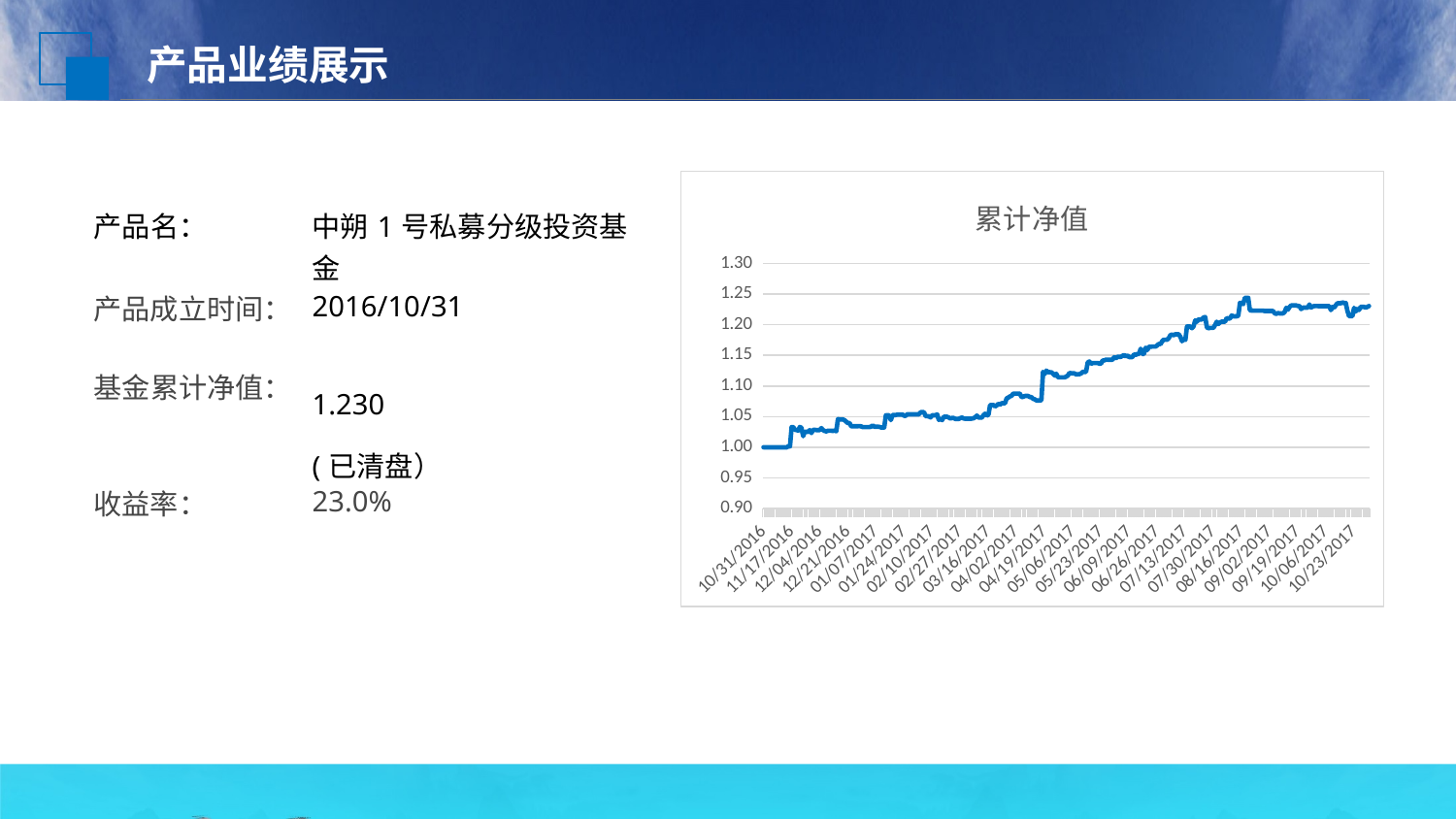
What is the highest value shown on the y axis of the 累计净值 chart? 1.30 How many lines are plotted in the 累计净值 chart? 1 Do the values in the 累计净值 chart generally rise or fall from left to right along the x axis? rise Is the lowest point of the line in the 累计净值 chart greater or less than 0.95? greater Is the value at 08/16/2017 in the 累计净值 chart greater or less than 1.20? greater What is the first date label on the x axis of the 累计净值 chart? 10/31/2016 What is the title of the chart? 累计净值 Is the value at 10/23/2017 in the 累计净值 chart greater or less than 1.20? greater Which is larger in the 累计净值 chart, the value at 10/31/2016 or the value at 10/23/2017? 10/23/2017 What kind of chart is shown on the slide? line chart